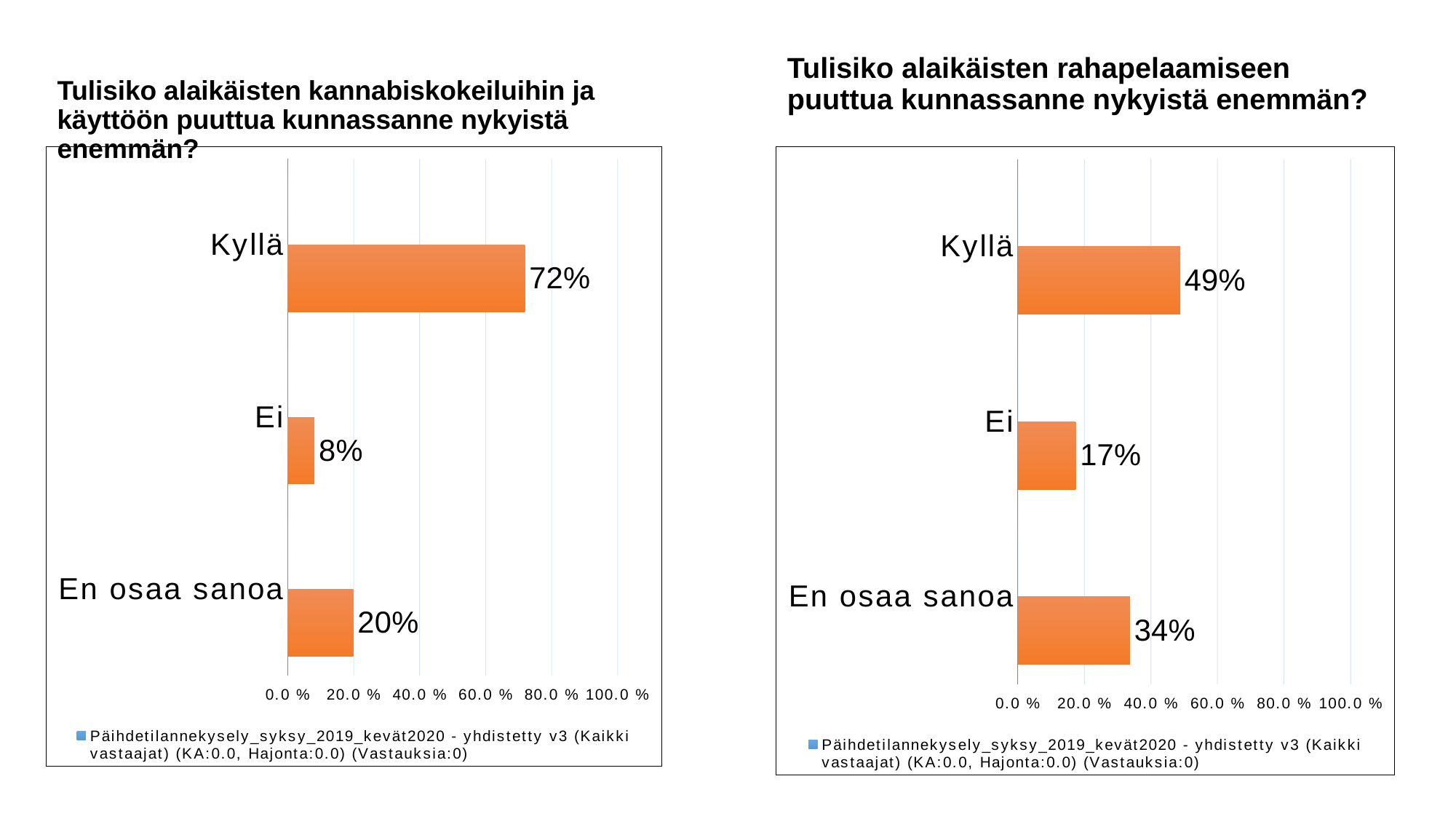
Which is larger: Kyllä in the left chart or Kyllä in the right chart? Kyllä in the left chart What is the title of the right chart? Tulisiko alaikäisten rahapelaamiseen puuttua kunnassanne nykyistä enemmän? In the right chart (rahapelaamiseen), what is the value for Ei? 17% In the left chart (kannabiskokeiluihin), what is the value for Ei? 8% In the left chart (kannabiskokeiluihin), what is the difference between Kyllä and En osaa sanoa? 52% In the right chart (rahapelaamiseen), what is the value for En osaa sanoa? 34% In the left chart (kannabiskokeiluihin), which category has the lowest value? Ei In the right chart (rahapelaamiseen), which category has the highest value? Kyllä In the left chart (kannabiskokeiluihin), what is the value for Kyllä? 72% How many categories does the left chart (kannabiskokeiluihin) show? 3 In the right chart (rahapelaamiseen), what is the difference between Kyllä and Ei? 32% What type of chart is the right chart (rahapelaamiseen)? Bar chart